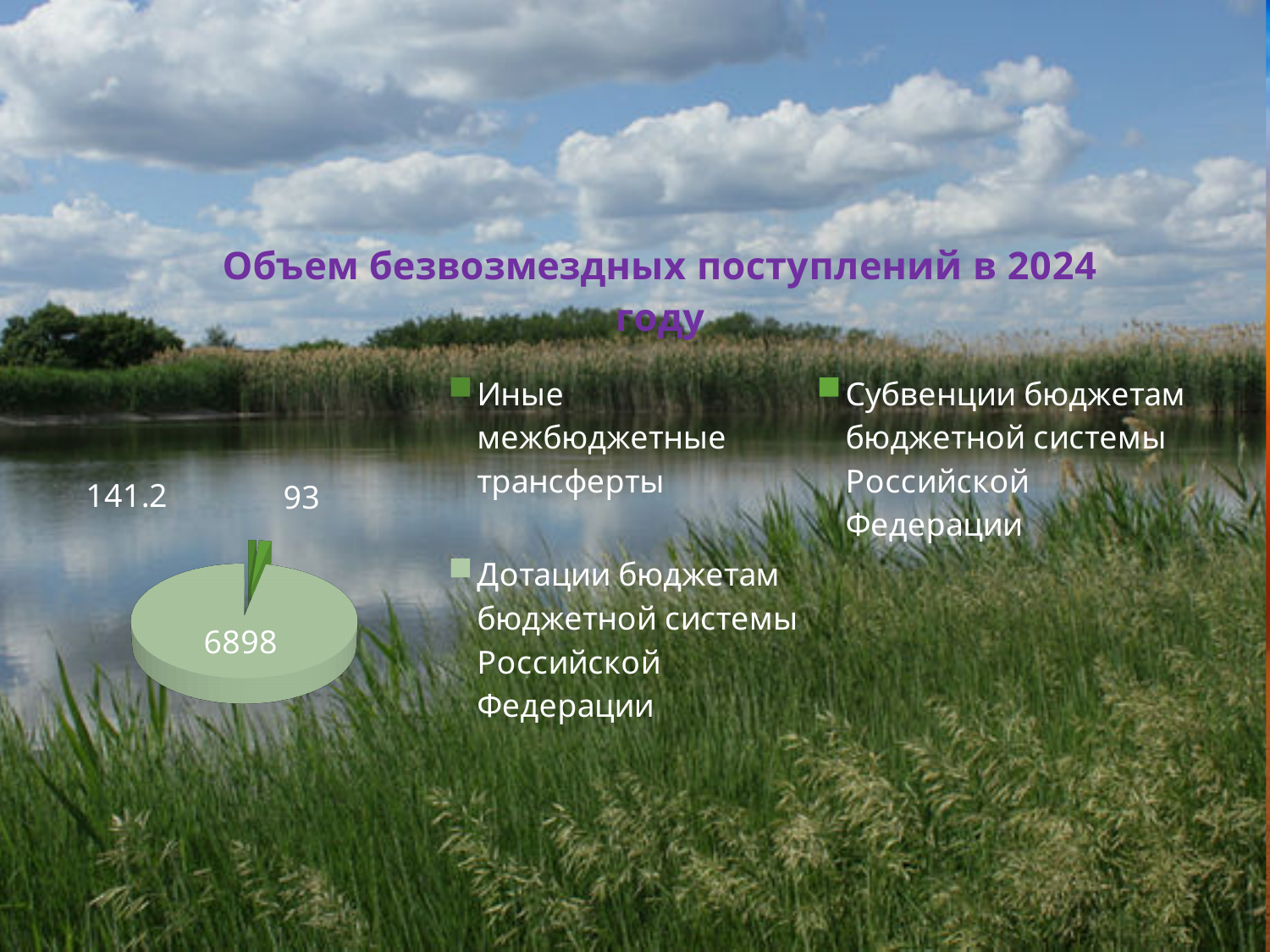
What value is labelled on the largest slice of the pie? 6898 Is the value for Дотации бюджетам бюджетной системы Российской Федерации larger or smaller than the combined value of the other two slices? Larger What colour is the slice for Дотации бюджетам бюджетной системы Российской Федерации? Light green Which category has the largest slice of the pie? Дотации бюджетам бюджетной системы Российской Федерации What is the title of the chart? Объем безвозмездных поступлений в 2024 году How many entries does the chart legend list? 3 How many slices does the pie chart have? 3 What is the smallest data label shown on the chart? 93 What kind of chart is shown on the slide? Pie chart What is the total of the three data labels shown on the chart (6898, 141.2 and 93)? 7132.2 What is the difference between the two smaller data labels, 141.2 and 93? 48.2